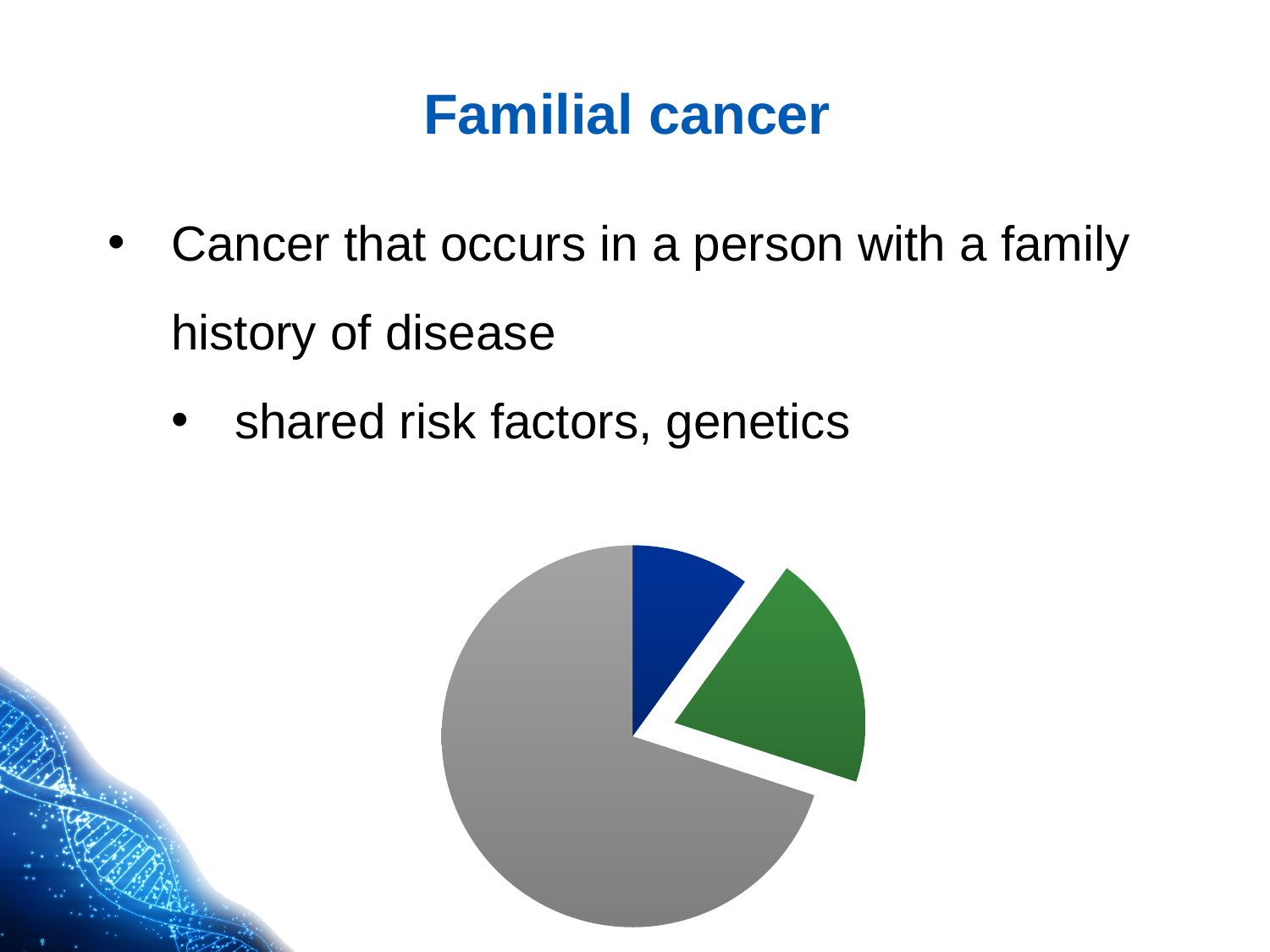
Does the gray slice take up more or less than half of the pie chart? more Which slice of the pie chart is the smallest? the blue slice Which slice of the pie chart is pulled out (exploded) from the rest of the pie? the green slice Which slice of the pie chart is the largest? the gray slice What kind of chart is shown on the slide? pie chart Which is larger in the pie chart, the green slice or the blue slice? the green slice Does the pie chart have a legend? No How many slices does the pie chart have? 3 Which is larger in the pie chart, the gray slice or the green slice? the gray slice